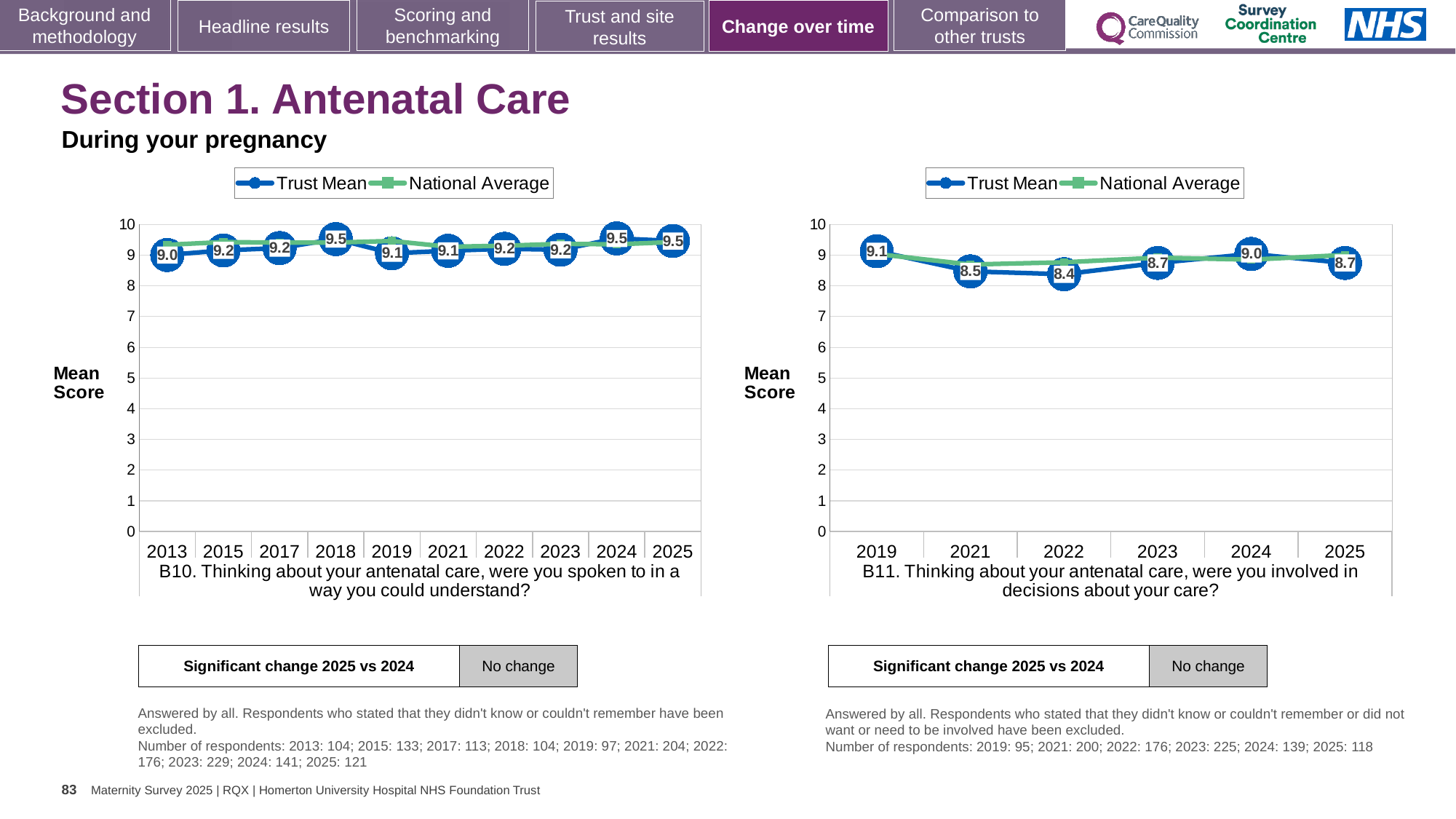
In the B10 chart on the left, which year has the higher Trust Mean score, 2018 or 2019? 2018 In the B10 chart on the left, which year has the lowest Trust Mean score? 2013 In the B10 chart on the left, what is the Trust Mean score for 2018? 9.5 In the B11 chart on the right, is the Trust Mean score for 2022 greater or less than 9? less In the B11 chart on the right, which year has the lowest Trust Mean score? 2022 In the B11 chart on the right, what is the Trust Mean score for 2022? 8.4 How many series does the legend of the B11 chart on the right list? 2 What kind of chart is the B10 chart on the left? Line chart In the B11 chart on the right, what is the difference between the Trust Mean scores for 2019 and 2022? 0.7 In the B11 chart on the right, which year has the highest Trust Mean score? 2019 In the B11 chart on the right, what is the Trust Mean score for 2024? 9.0 How many years are plotted on the x axis of the B10 chart on the left? 10